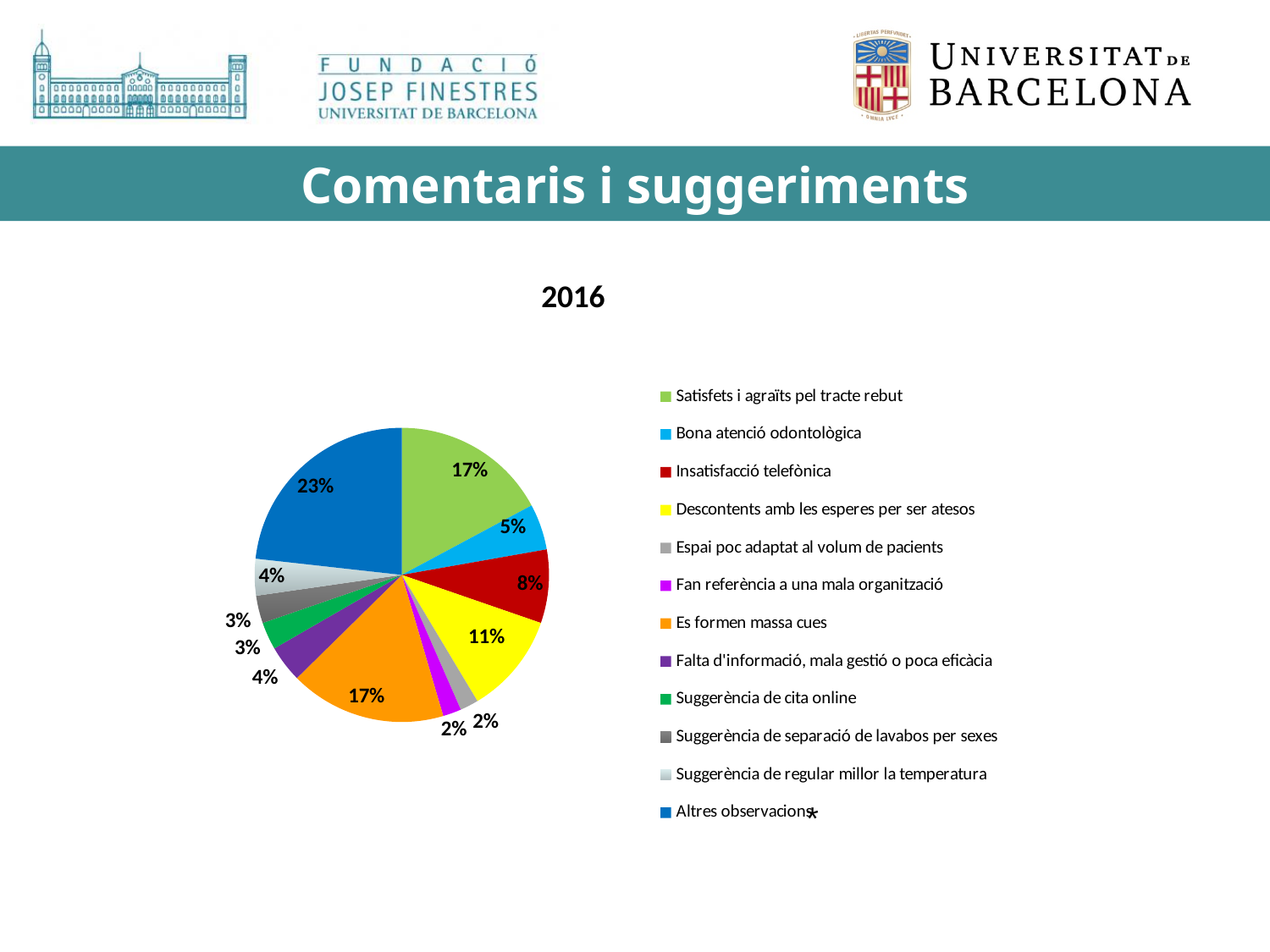
What share of the pie is 'Insatisfacció telefònica'? 8% How many entries does the legend list? 12 What share of the pie is 'Satisfets i agraïts pel tracte rebut'? 17% What kind of chart is shown on the slide? pie chart What share of the pie is 'Altres observacions'? 23% Which category has the largest slice of the pie? Altres observacions What is the title of the chart? 2016 What colour is the slice for 'Es formen massa cues'? orange Which is larger, the slice for 'Insatisfacció telefònica' or the slice for 'Bona atenció odontològica'? Insatisfacció telefònica What is the difference in percentage points between 'Altres observacions' and 'Descontents amb les esperes per ser atesos'? 12